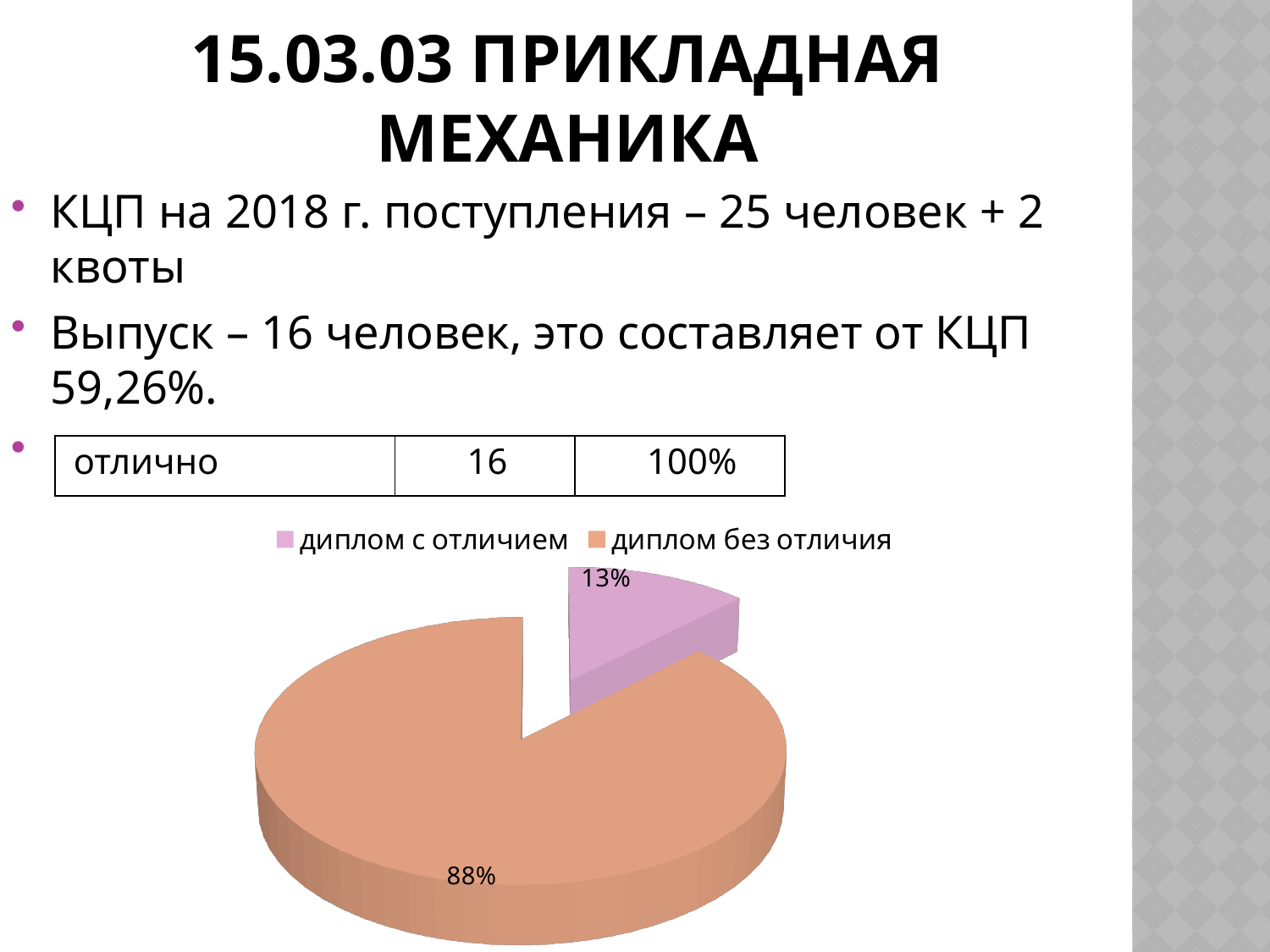
What is the difference in percentage points between the "диплом без отличия" slice and the "диплом с отличием" slice? 75 How many slices does the pie chart have? 2 Which is larger: the slice for "диплом с отличием" or the slice for "диплом без отличия"? диплом без отличия What share of the pie is labelled "диплом без отличия"? 88% Which slice of the pie is the smallest? диплом с отличием Which slice of the pie is the largest? диплом без отличия Where is the legend positioned relative to the pie chart? above the chart What kind of chart is shown on the slide? pie chart What share of the pie is labelled "диплом с отличием"? 13% What colour is the slice for "диплом с отличием"? pink How many entries does the legend of the pie chart list? 2